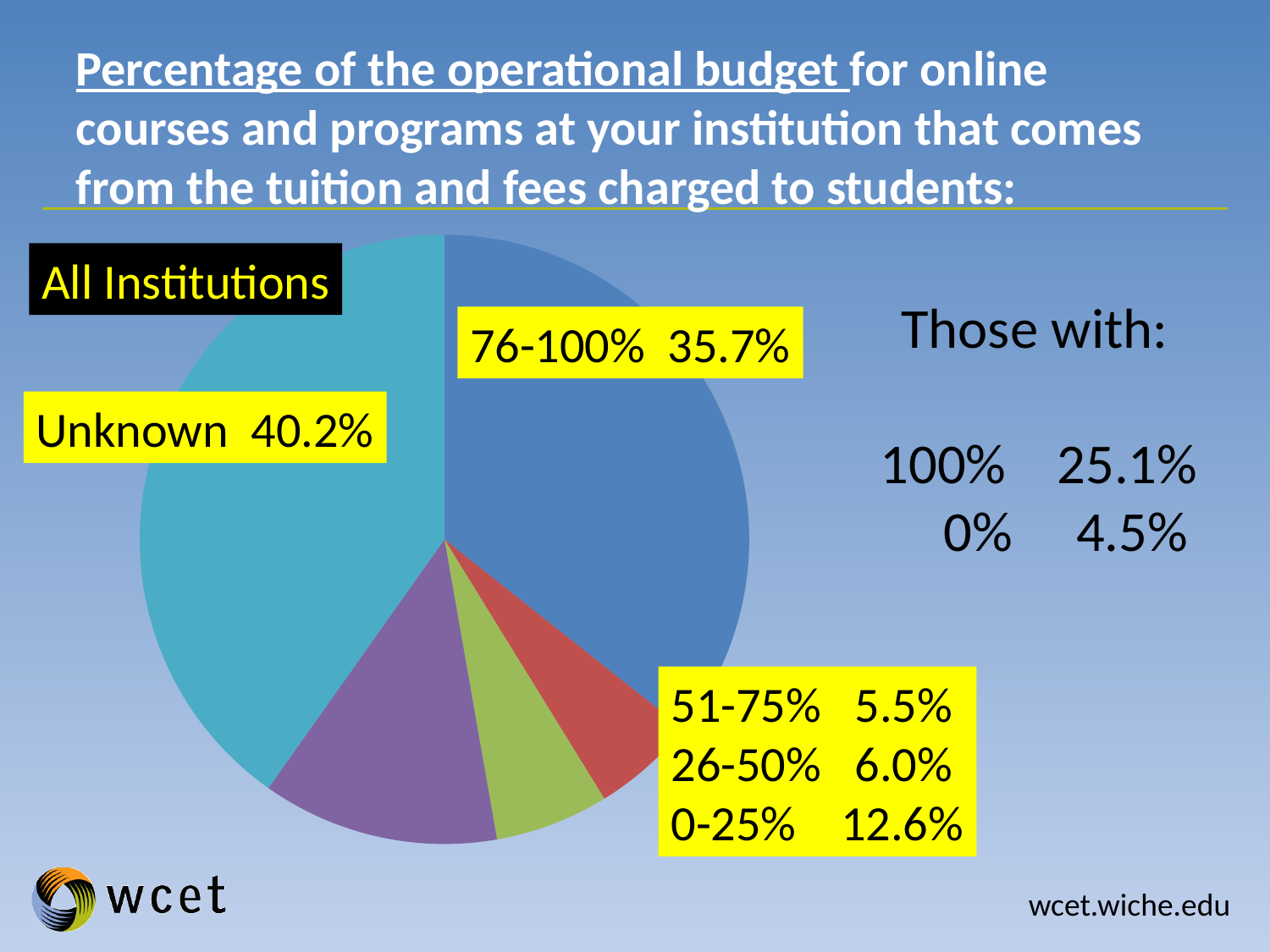
What kind of chart is shown on the slide? pie chart Which category has the largest slice of the pie? Unknown What share of institutions falls in the 51-75% category? 5.5% What share of institutions falls in the 0-25% category? 12.6% What share of institutions falls in the 76-100% category? 35.7% What share of institutions is labelled Unknown? 40.2% What is the difference between the Unknown share and the 76-100% share? 4.5% How many slices does the pie chart have? 5 Which is larger, the 0-25% share or the 26-50% share? 0-25% What share of institutions falls in the 26-50% category? 6.0% Which category has the smallest slice of the pie? 51-75% According to the text beside the chart, what share of institutions get 100% of the operational budget from tuition and fees? 25.1%